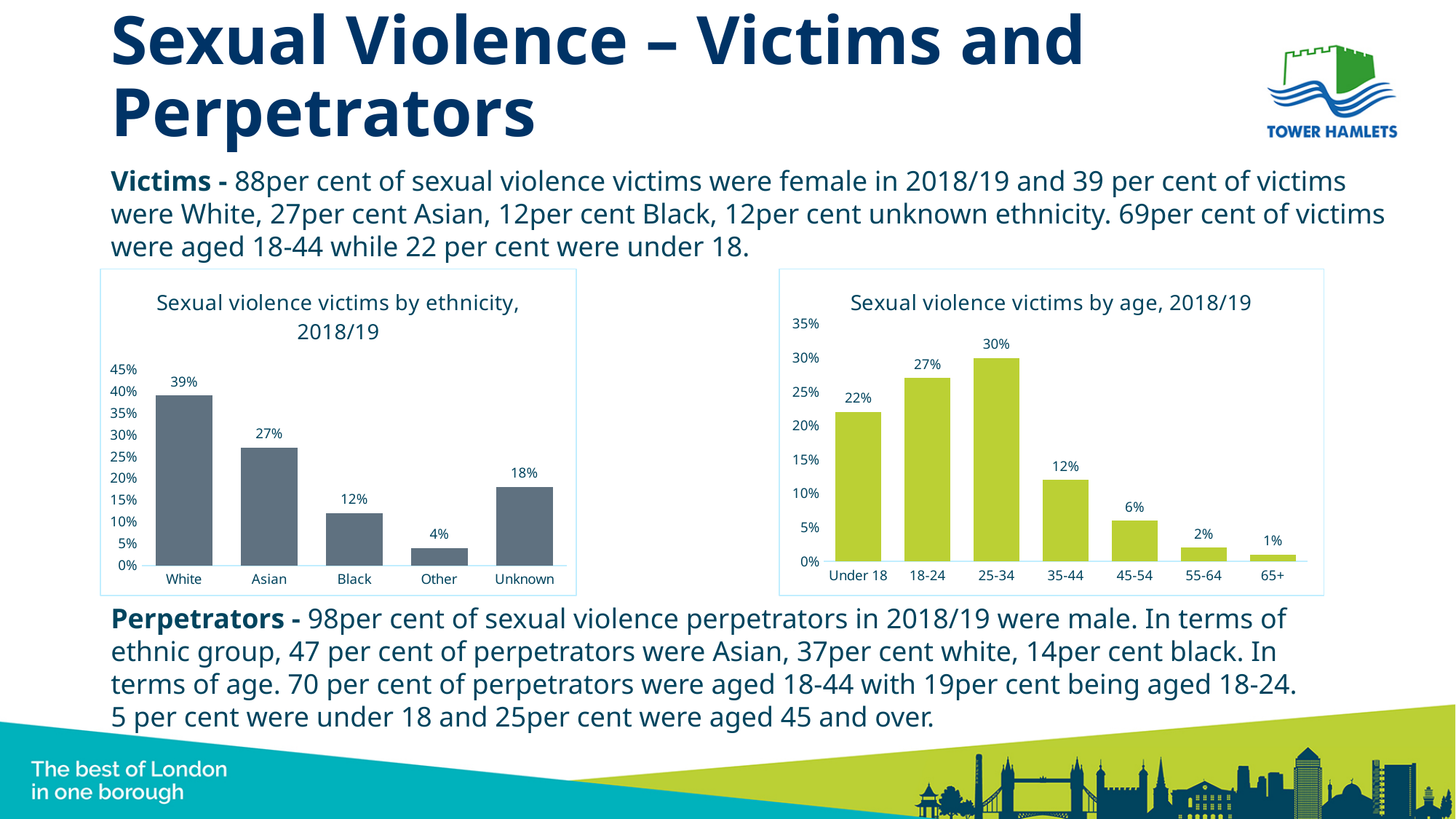
In the 'Sexual violence victims by ethnicity, 2018/19' chart, what is the value for White? 39% In the 'Sexual violence victims by age, 2018/19' chart, how many age groups are shown? 7 In the 'Sexual violence victims by age, 2018/19' chart, do the values rise or fall from 25-34 to 65+? fall What type of chart is the 'Sexual violence victims by age, 2018/19' chart? bar chart In the 'Sexual violence victims by age, 2018/19' chart, which age group has the lowest value? 65+ In the 'Sexual violence victims by age, 2018/19' chart, what is the difference between the values for 25-34 and Under 18? 8% In the 'Sexual violence victims by ethnicity, 2018/19' chart, how many categories are shown? 5 In the 'Sexual violence victims by age, 2018/19' chart, which age group has the highest value? 25-34 In the 'Sexual violence victims by ethnicity, 2018/19' chart, which is larger, Unknown or Black? Unknown In the 'Sexual violence victims by ethnicity, 2018/19' chart, which category has the lowest value? Other In the 'Sexual violence victims by ethnicity, 2018/19' chart, what is the difference between the values for Asian and Black? 15% In the 'Sexual violence victims by age, 2018/19' chart, what is the value for 35-44? 12%